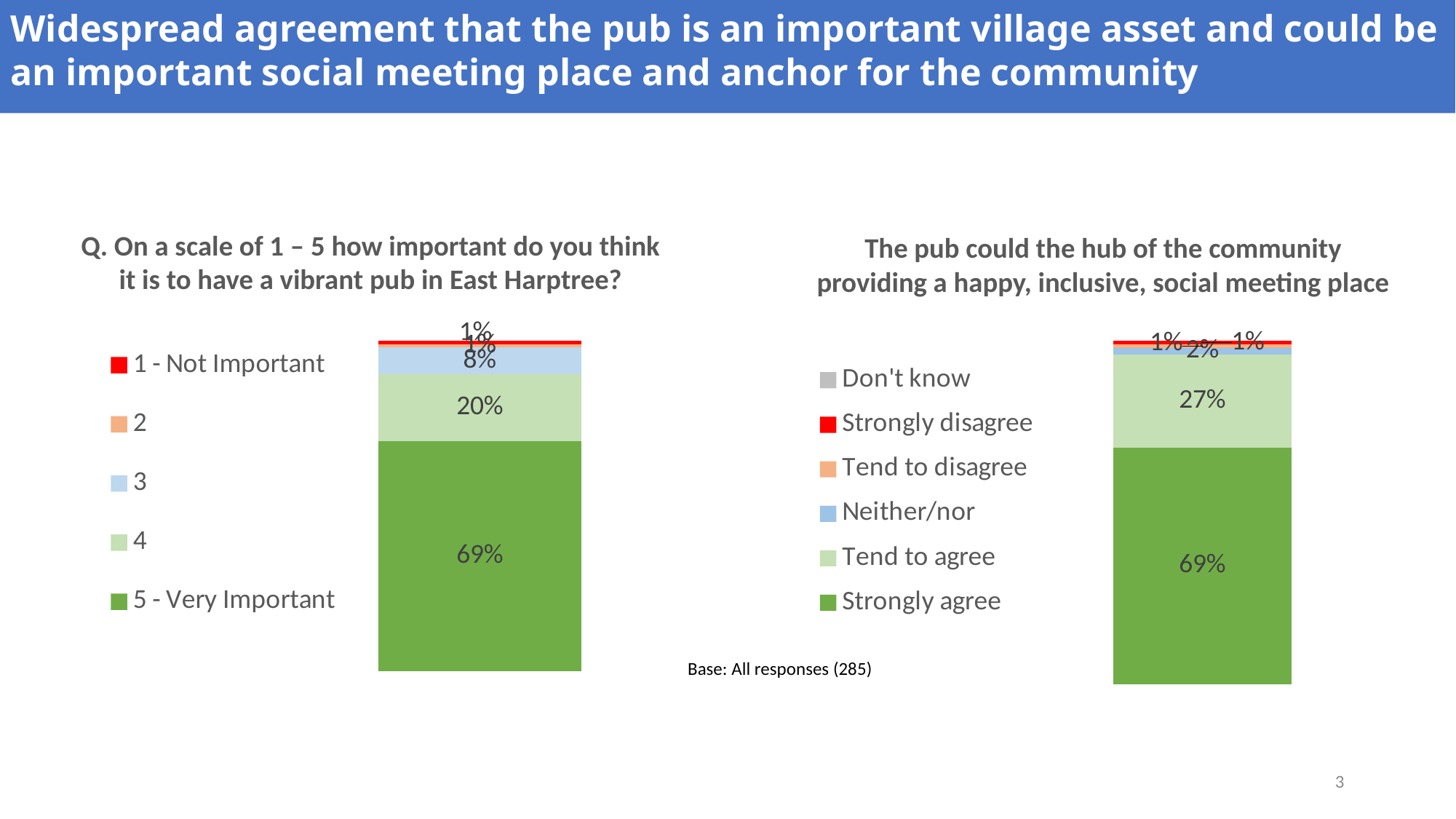
In the right chart on the pub being the hub of the community, how many categories does the legend list? 6 In the left chart on how important a vibrant pub is in East Harptree, how many categories does the legend list? 5 In the right chart on the pub being the hub of the community, what percentage tend to agree? 27% In the left chart on how important a vibrant pub is in East Harptree, what percentage rated it 5 - Very Important? 69% What kind of chart is used on the right side of the slide for the pub being the hub of the community? Stacked bar chart In the left chart on how important a vibrant pub is in East Harptree, what percentage gave a rating of 3? 8% In the left chart on how important a vibrant pub is in East Harptree, what percentage gave a rating of 4? 20% In the right chart on the pub being the hub of the community, what percentage strongly agree? 69% In the left chart on how important a vibrant pub is in East Harptree, which rating has the largest share? 5 - Very Important In the left chart on how important a vibrant pub is in East Harptree, what is the difference between the share rating 5 - Very Important and the share rating 4? 49% In the right chart on the pub being the hub of the community, which is larger: Strongly agree or Tend to agree? Strongly agree In the right chart on the pub being the hub of the community, what is the difference between the Strongly agree and Tend to agree shares? 42%